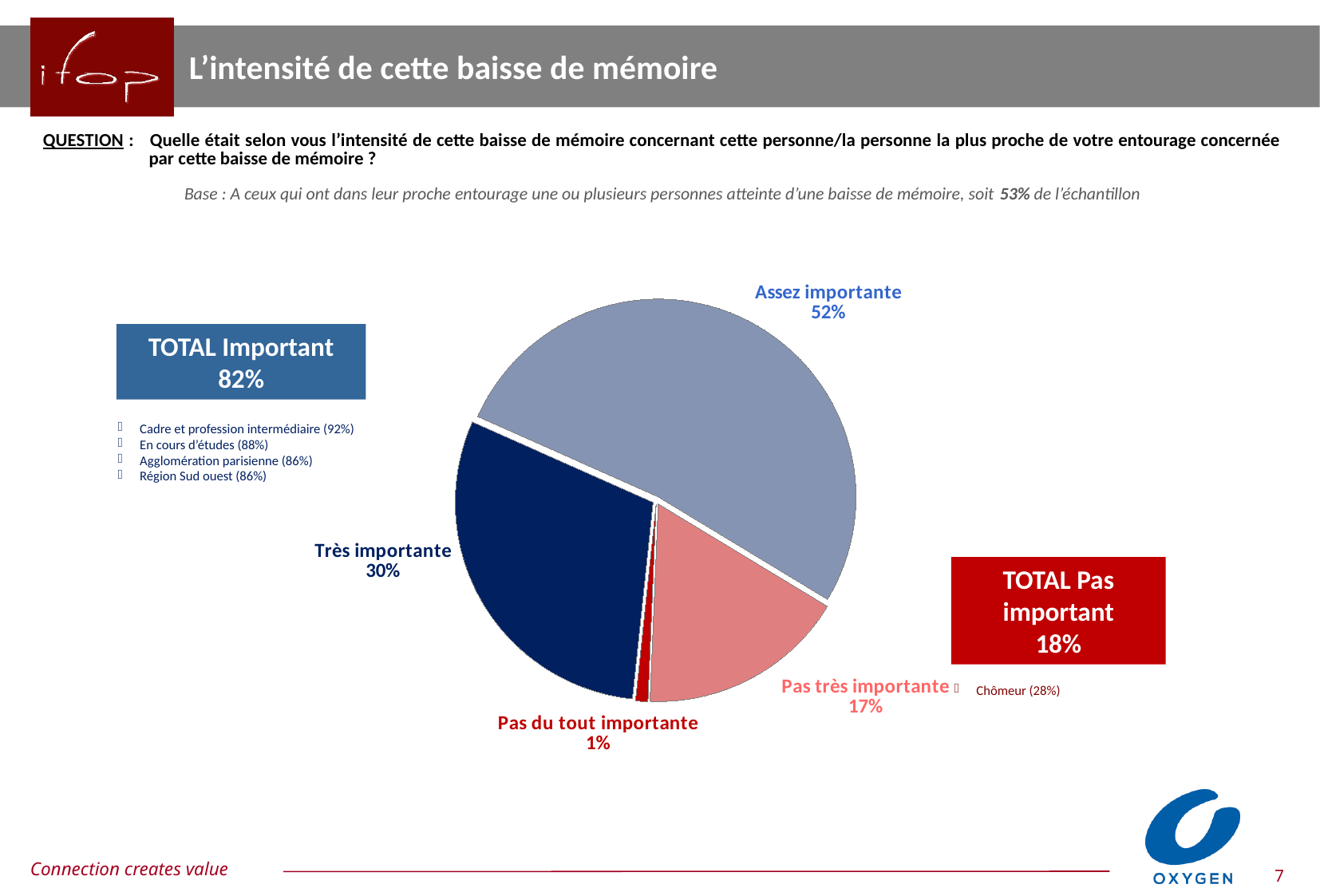
What share of the pie is labelled "Pas très importante"? 17% Which is larger, the "Très importante" slice or the "Pas très importante" slice? Très importante How many slices does the pie chart have? 4 What is the difference between the "Assez importante" and "Très importante" shares? 22 percentage points What share of the pie is labelled "Assez importante"? 52% Which slice of the pie is the largest? Assez importante What share of the pie is labelled "Très importante"? 30% What is the combined share of "Très importante" and "Assez importante" (TOTAL Important)? 82% What is the combined share of "Pas très importante" and "Pas du tout importante" (TOTAL Pas important)? 18% Which slice of the pie is the smallest? Pas du tout importante What kind of chart is shown on the slide? pie chart